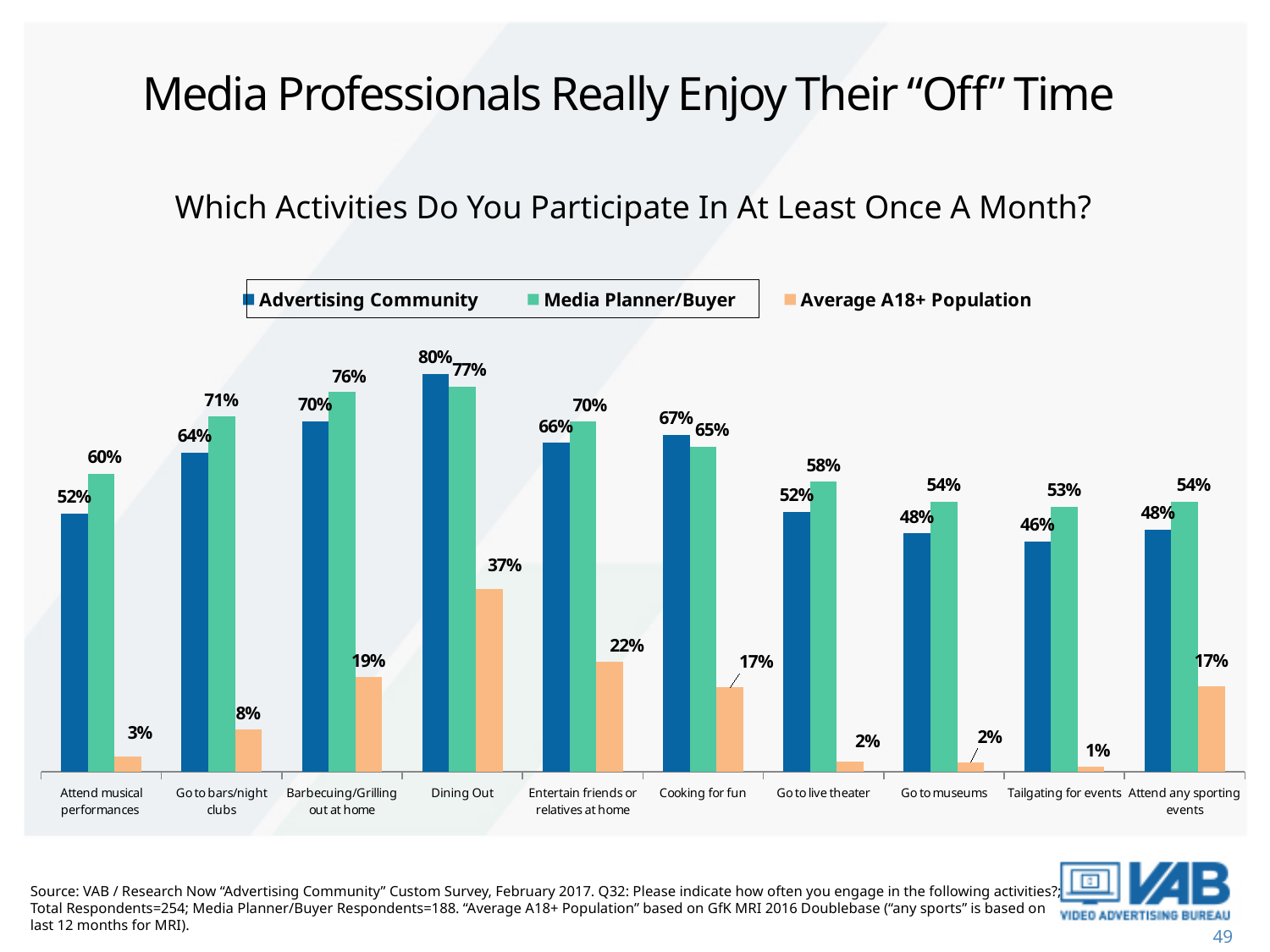
What kind of chart is shown on the slide? Bar chart How many activities are shown on the x axis of the chart? 10 What percentage of the Advertising Community participates in Dining Out at least once a month? 80% What is the difference between the Average A18+ Population values for Dining Out and Entertain friends or relatives at home? 15% Which activity has the lowest Advertising Community value? Tailgating for events What is the Average A18+ Population value for Tailgating for events? 1% For Cooking for fun, which is larger: the Advertising Community value or the Media Planner/Buyer value? Advertising Community Which activity has the highest Average A18+ Population value? Dining Out What is the Media Planner/Buyer value for Barbecuing/Grilling out at home? 76% What is the difference between the Media Planner/Buyer and Advertising Community values for Attend musical performances? 8% How many series does the legend list? 3 Which series is shown in orange in the legend? Average A18+ Population